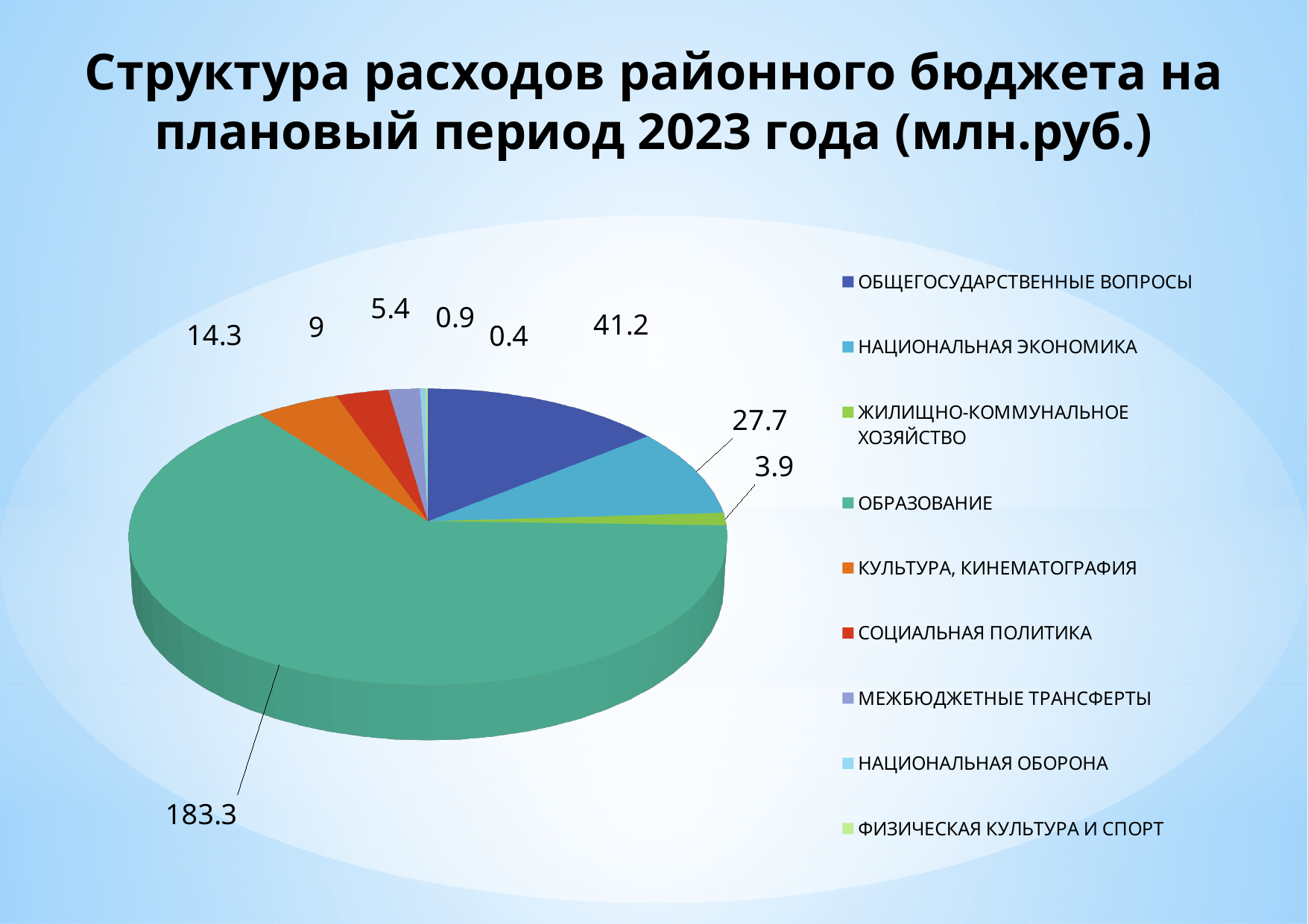
What kind of chart is shown on the slide? Pie chart What is the value for НАЦИОНАЛЬНАЯ ЭКОНОМИКА? 27.7 Which category has the largest slice of the pie? ОБРАЗОВАНИЕ What is the value for КУЛЬТУРА, КИНЕМАТОГРАФИЯ? 14.3 Which category has the smallest slice of the pie? ФИЗИЧЕСКАЯ КУЛЬТУРА И СПОРТ What is the title of the chart on the slide? Структура расходов районного бюджета на плановый период 2023 года (млн.руб.) What is the difference between the values for ОБЩЕГОСУДАРСТВЕННЫЕ ВОПРОСЫ and НАЦИОНАЛЬНАЯ ЭКОНОМИКА? 13.5 What is the value for ОБРАЗОВАНИЕ? 183.3 How many categories does the legend list? 9 What is the value for ЖИЛИЩНО-КОММУНАЛЬНОЕ ХОЗЯЙСТВО? 3.9 What is the value for ОБЩЕГОСУДАРСТВЕННЫЕ ВОПРОСЫ? 41.2 Which is larger, the value for СОЦИАЛЬНАЯ ПОЛИТИКА or the value for МЕЖБЮДЖЕТНЫЕ ТРАНСФЕРТЫ? СОЦИАЛЬНАЯ ПОЛИТИКА